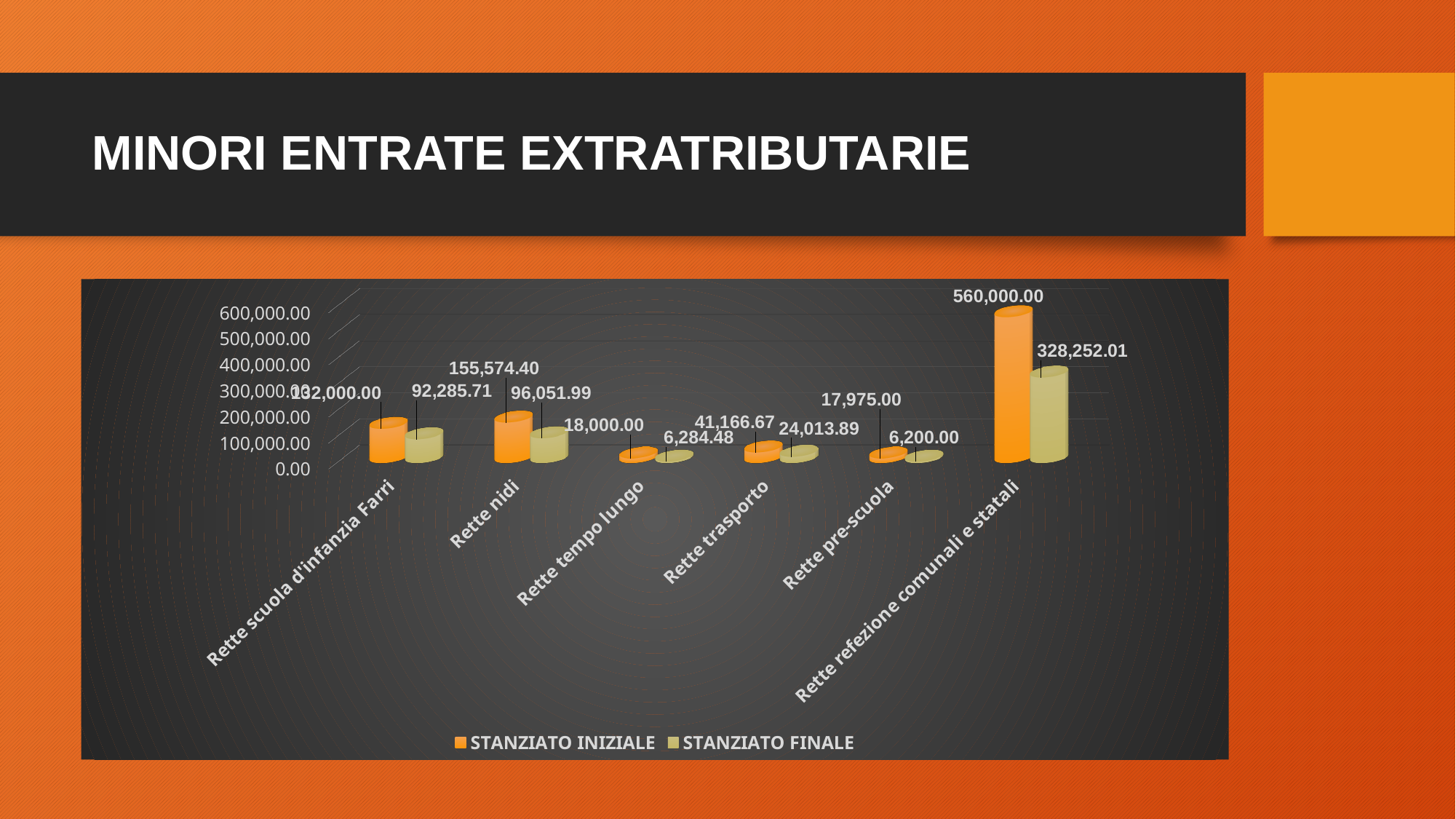
What is the STANZIATO FINALE value for Rette nidi? 96,051.99 How many categories are shown on the x axis? 6 What is the difference between STANZIATO INIZIALE and STANZIATO FINALE for Rette tempo lungo? 11,715.52 Which category has the lowest STANZIATO FINALE value? Rette pre-scuola What is the STANZIATO INIZIALE value for Rette refezione comunali e statali? 560,000.00 What is the STANZIATO INIZIALE value for Rette trasporto? 41,166.67 Which is larger for Rette trasporto: STANZIATO INIZIALE or STANZIATO FINALE? STANZIATO INIZIALE What is the STANZIATO FINALE value for Rette pre-scuola? 6,200.00 Which category has the highest STANZIATO INIZIALE value? Rette refezione comunali e statali What type of chart is shown on the slide? Bar chart How many series does the legend list? 2 Is the STANZIATO FINALE value for Rette refezione comunali e statali greater or less than 300,000.00? greater